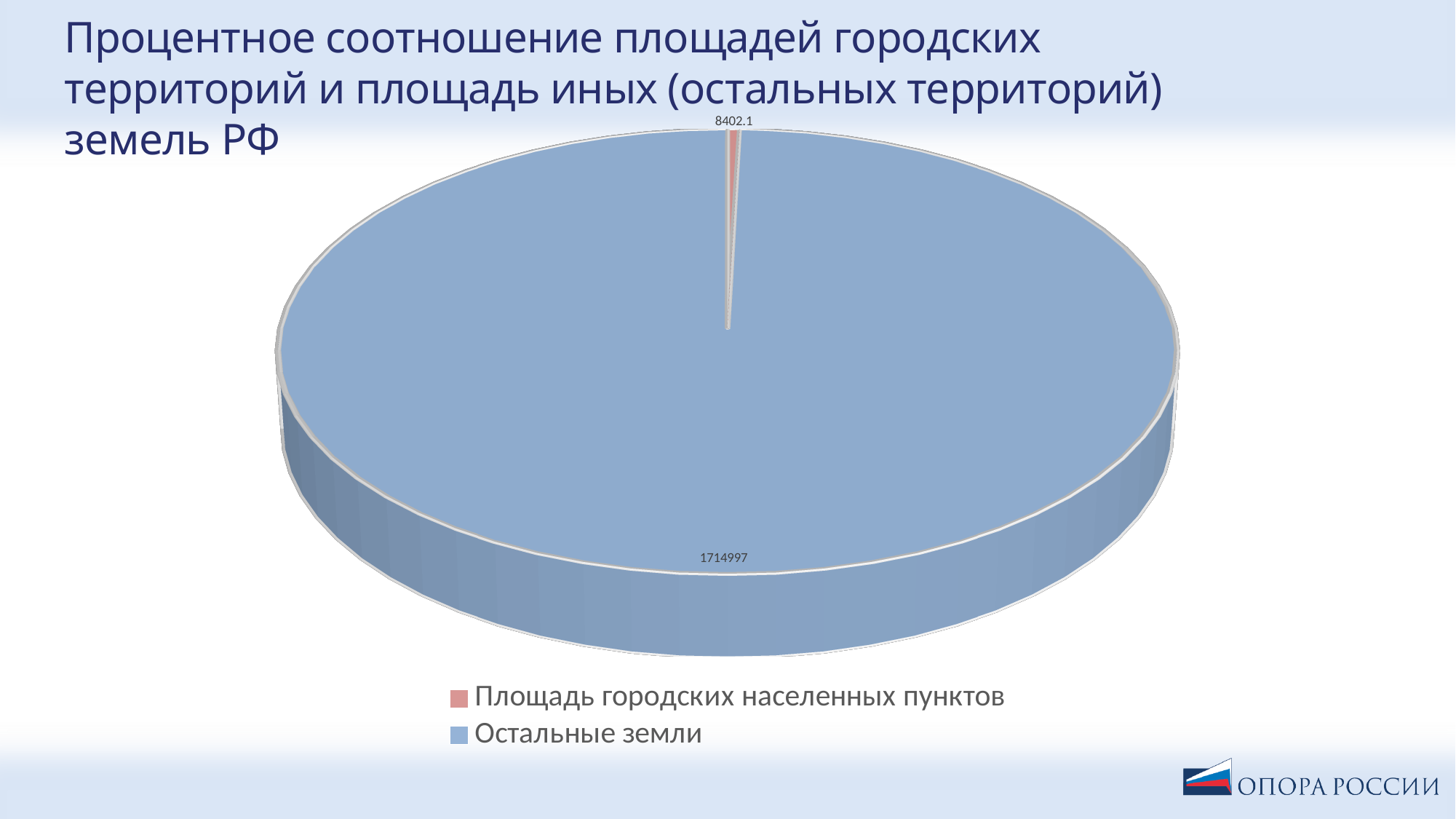
What is the total of the two values shown on the pie chart? 1723399.1 What value is shown for the slice "Остальные земли"? 1714997 What value is shown for the slice "Площадь городских населенных пунктов"? 8402.1 How many entries does the legend list? 2 What is the difference between the value for "Остальные земли" and the value for "Площадь городских населенных пунктов"? 1706594.9 Which category has the largest slice of the pie? Остальные земли How many slices does the pie chart have? 2 Which category has the smallest slice of the pie? Площадь городских населенных пунктов What kind of chart is shown on the slide? Pie chart What colour is the slice for "Площадь городских населенных пунктов"? Red (pink) What colour is the slice for "Остальные земли"? Blue Which is larger: the value for "Остальные земли" or the value for "Площадь городских населенных пунктов"? Остальные земли